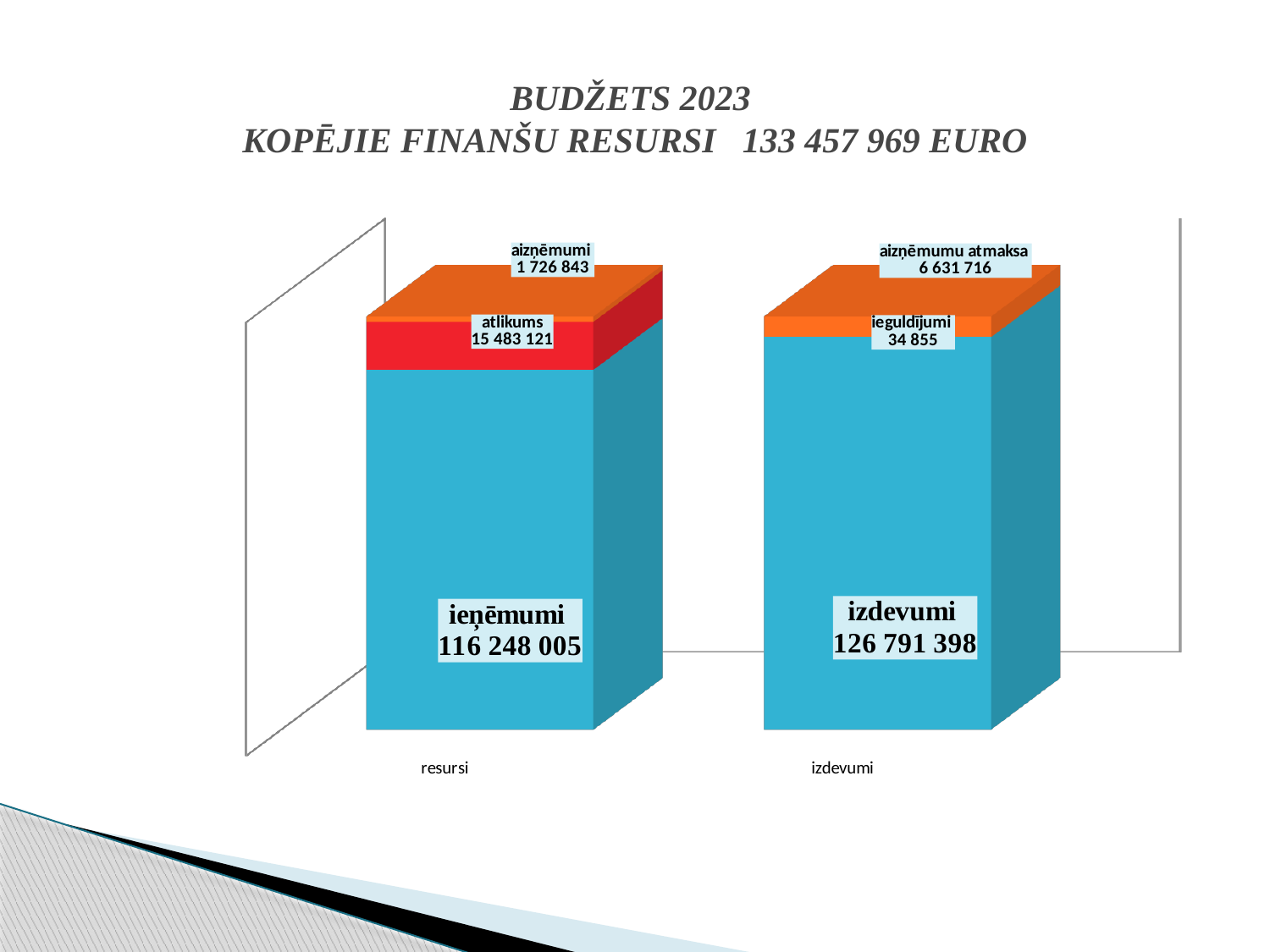
What is the value of the izdevumi segment in the izdevumi bar? 126 791 398 What is the value of the ieņēmumi segment in the resursi bar? 116 248 005 What is the value of the ieguldījumi segment in the izdevumi bar? 34 855 What is the value of the atlikums segment in the resursi bar? 15 483 121 What kind of chart is shown on the slide? stacked bar chart How many bars are shown on the chart? 2 What is the total of the resursi stacked bar? 133 457 969 What is the value of the aizņēmumu atmaksa segment in the izdevumi bar? 6 631 716 What is the difference between the izdevumi segment (126 791 398) and the ieņēmumi segment (116 248 005)? 10 543 393 Which is larger, the atlikums segment or the aizņēmumi segment in the resursi bar? atlikums What total amount of financial resources is stated in the slide title? 133 457 969 EURO What is the value of the aizņēmumi segment in the resursi bar? 1 726 843